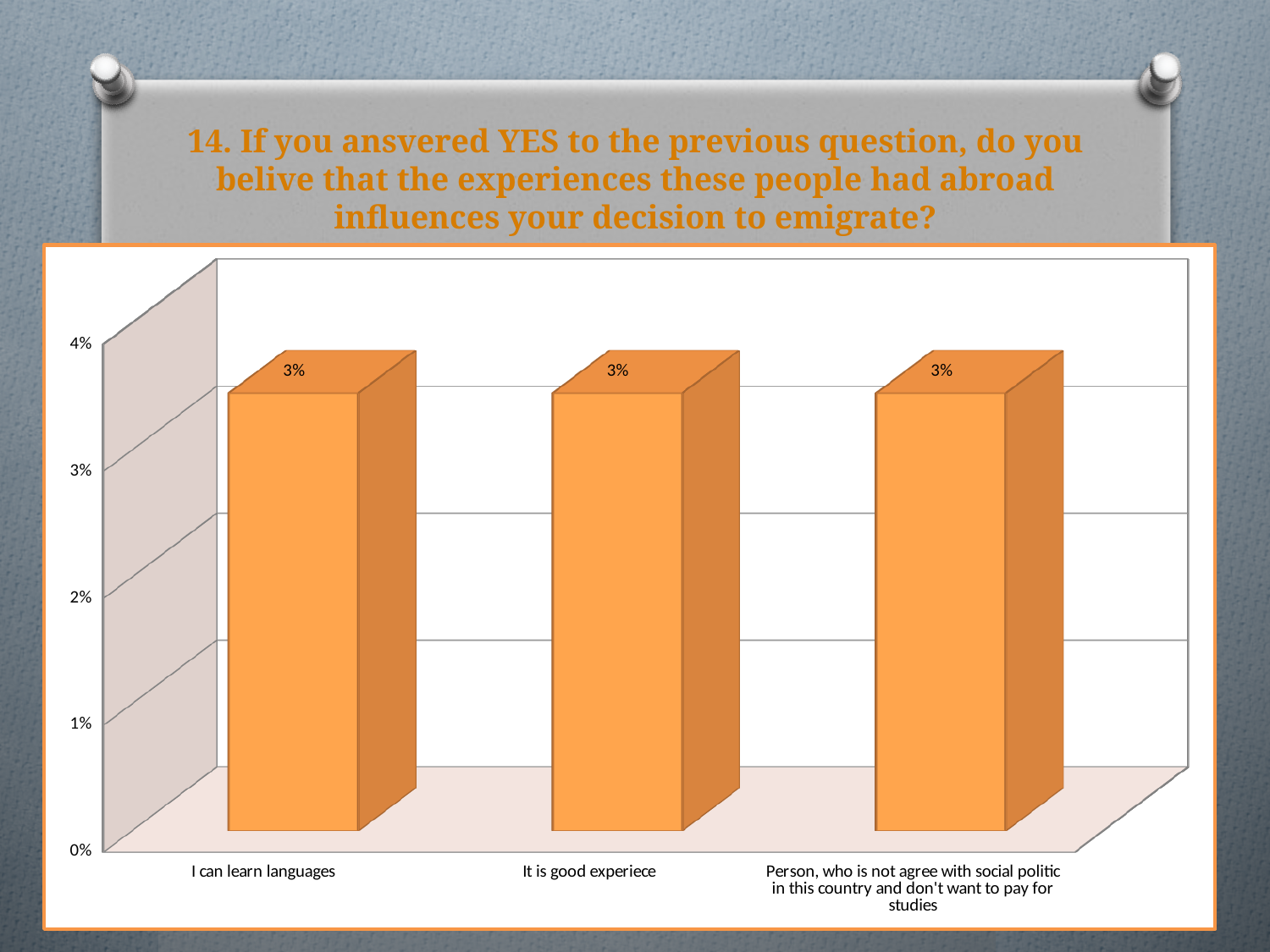
What is the difference between the values for "I can learn languages" and "It is good experiece"? 0% What kind of chart is shown on the slide? bar chart Is the value for "I can learn languages" greater or less than 4%? less Is the value for "It is good experiece" greater or less than 2%? greater What is the value for "It is good experiece"? 3% What is the highest value shown on the vertical axis? 4% What colour are the bars in the chart? orange What is the value for "I can learn languages"? 3% How many categories are shown on the chart? 3 Is the value for "I can learn languages" larger than, smaller than, or equal to the value for "It is good experiece"? equal Do the values rise, fall, or stay the same across the categories from left to right? stay the same What is the value for "Person, who is not agree with social politic in this country and don't want to pay for studies"? 3%